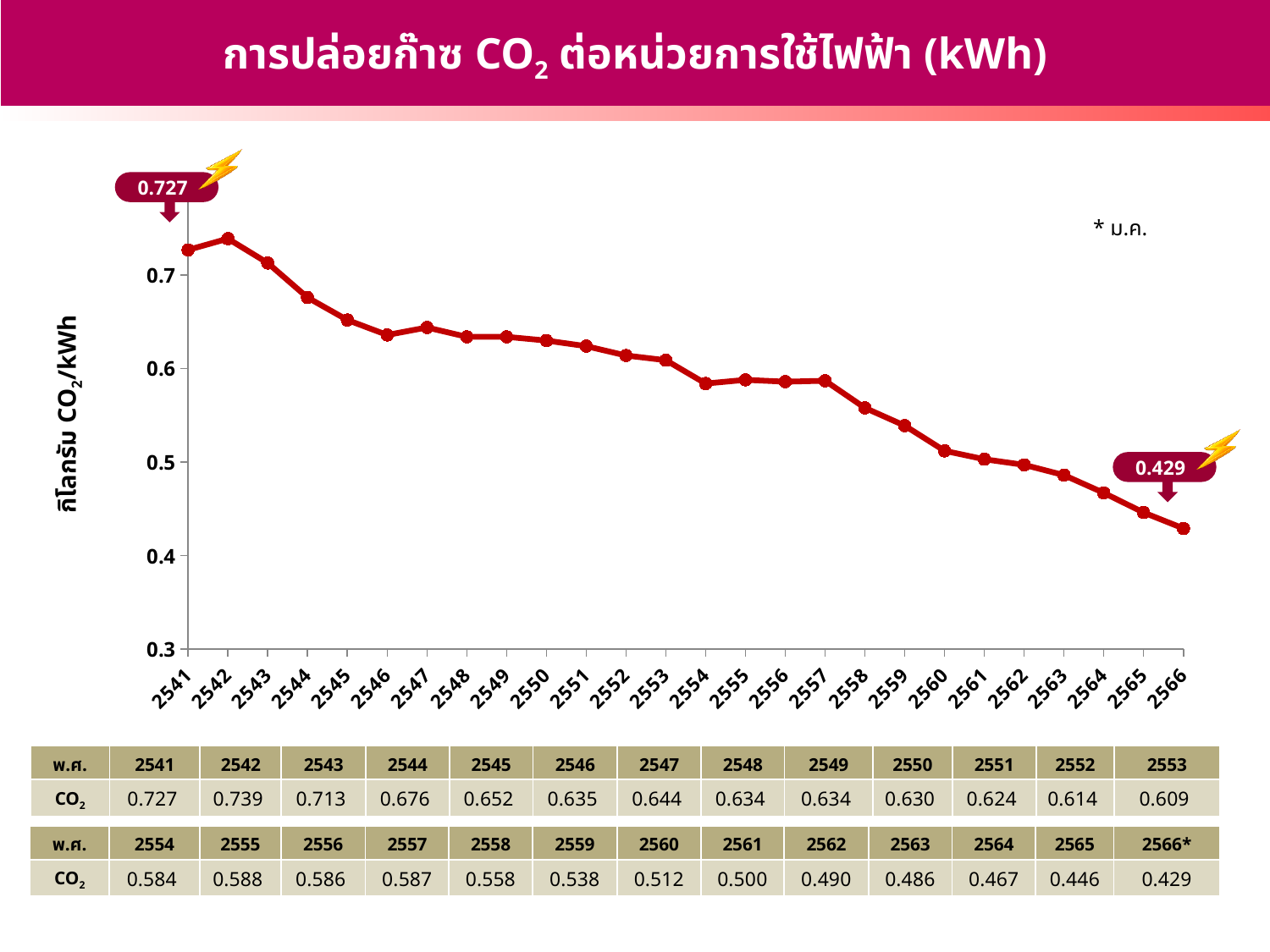
How many years are plotted on the chart? 26 Which year has the lowest CO2 emission per kWh? 2566 Do the values generally rise or fall from 2541 to 2566? fall Which year has the highest CO2 emission per kWh? 2542 What is the CO2 emission value for the year 2566? 0.429 What is the difference between the values for 2542 and 2543? 0.026 What kind of chart is shown on the slide? line chart Which year has a larger value, 2544 or 2554? 2544 What is the difference between the values for 2541 and 2566? 0.298 What is the CO2 emission value for the year 2555? 0.588 What is the CO2 emission value for the year 2541? 0.727 Is the value for 2565 greater or less than 0.5? less